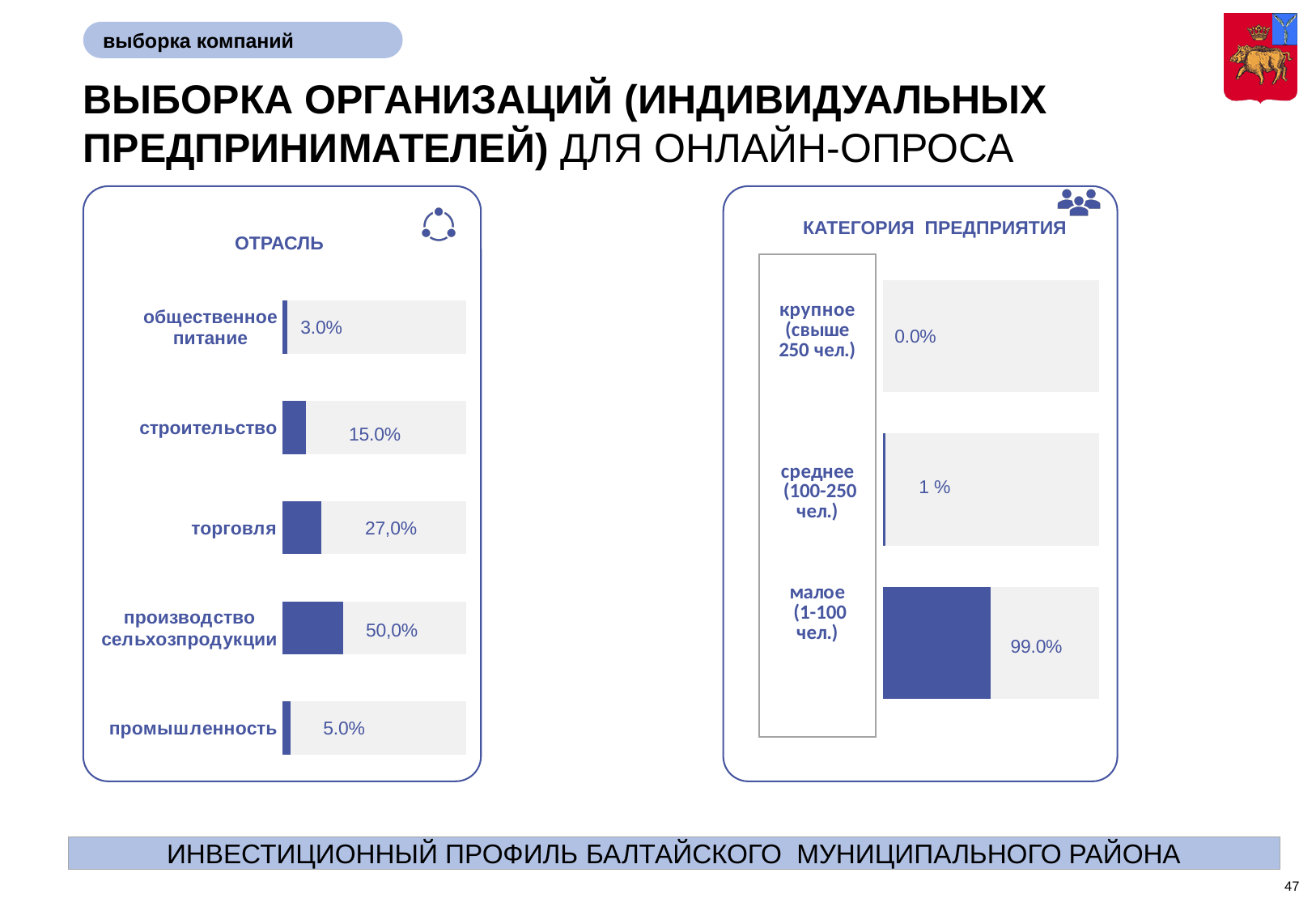
What kind of chart is the ОТРАСЛЬ chart? bar chart In the КАТЕГОРИЯ ПРЕДПРИЯТИЯ chart, what is the value for малое (1-100 чел.)? 99.0% In the ОТРАСЛЬ chart, what is the value for торговля? 27,0% How many categories are shown in the КАТЕГОРИЯ ПРЕДПРИЯТИЯ chart? 3 In the ОТРАСЛЬ chart, which category has the highest value? производство сельхозпродукции In the ОТРАСЛЬ chart, which is larger: промышленность or общественное питание? промышленность In the КАТЕГОРИЯ ПРЕДПРИЯТИЯ chart, what is the value for крупное (свыше 250 чел.)? 0.0% In the ОТРАСЛЬ chart, what is the value for строительство? 15.0% In the ОТРАСЛЬ chart, which category has the lowest value? общественное питание How many categories are shown in the ОТРАСЛЬ chart? 5 In the КАТЕГОРИЯ ПРЕДПРИЯТИЯ chart, which category has the highest value? малое (1-100 чел.) In the ОТРАСЛЬ chart, what is the difference between производство сельхозпродукции and торговля? 23 percentage points